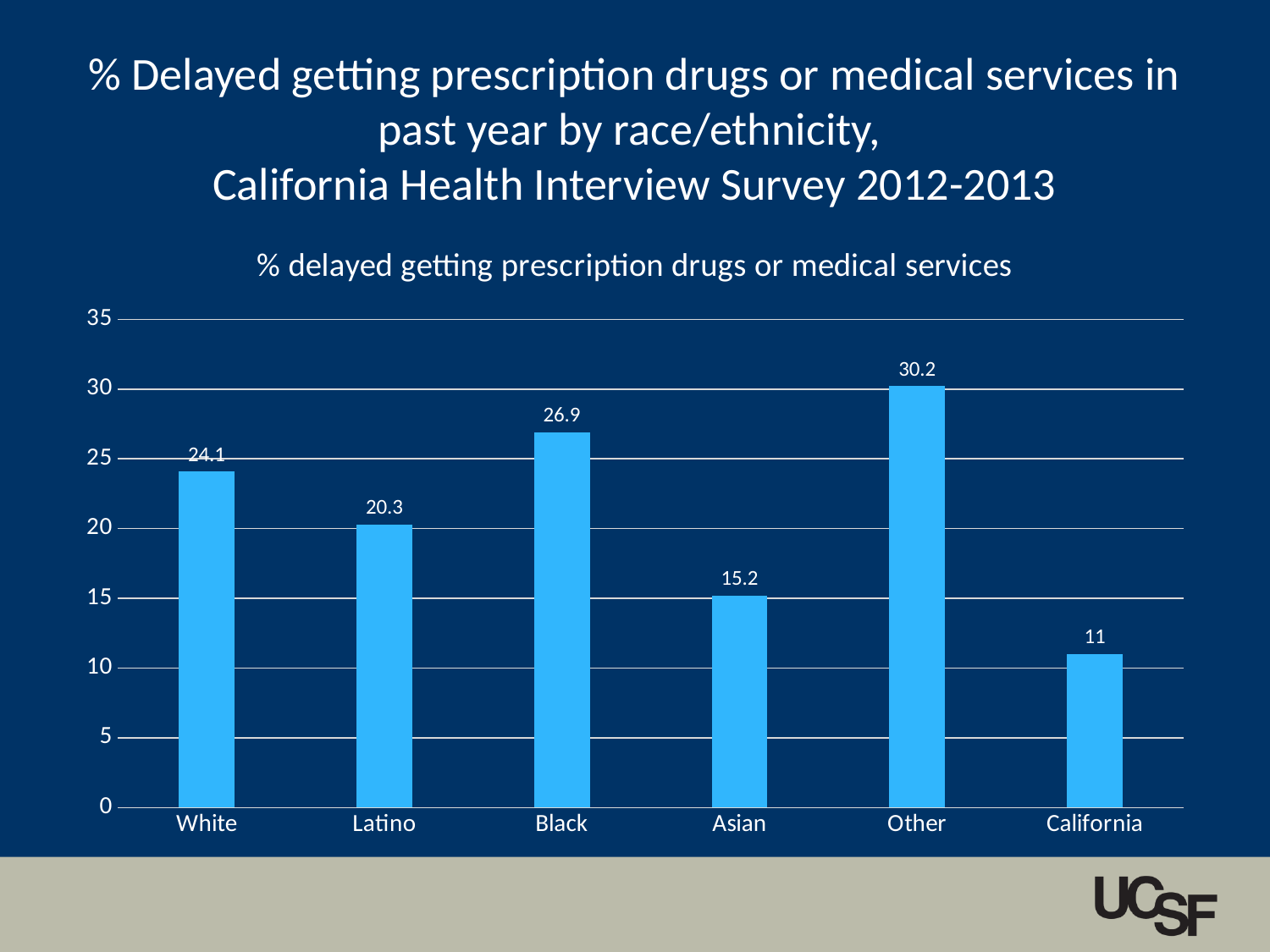
What kind of chart is shown on the slide? bar chart What is the value for Asian? 15.2 Which is larger, the value for White or the value for Latino? White What is the difference between the values for Black and Latino? 6.6 What is the value for California? 11 What is the difference between the values for Other and Asian? 15 What is the title shown directly above the chart? % delayed getting prescription drugs or medical services Is the value for Black greater or less than 25? greater How many categories are shown on the x axis? 6 Which category has the lowest value? California What is the value for White? 24.1 Which category has the highest value? Other